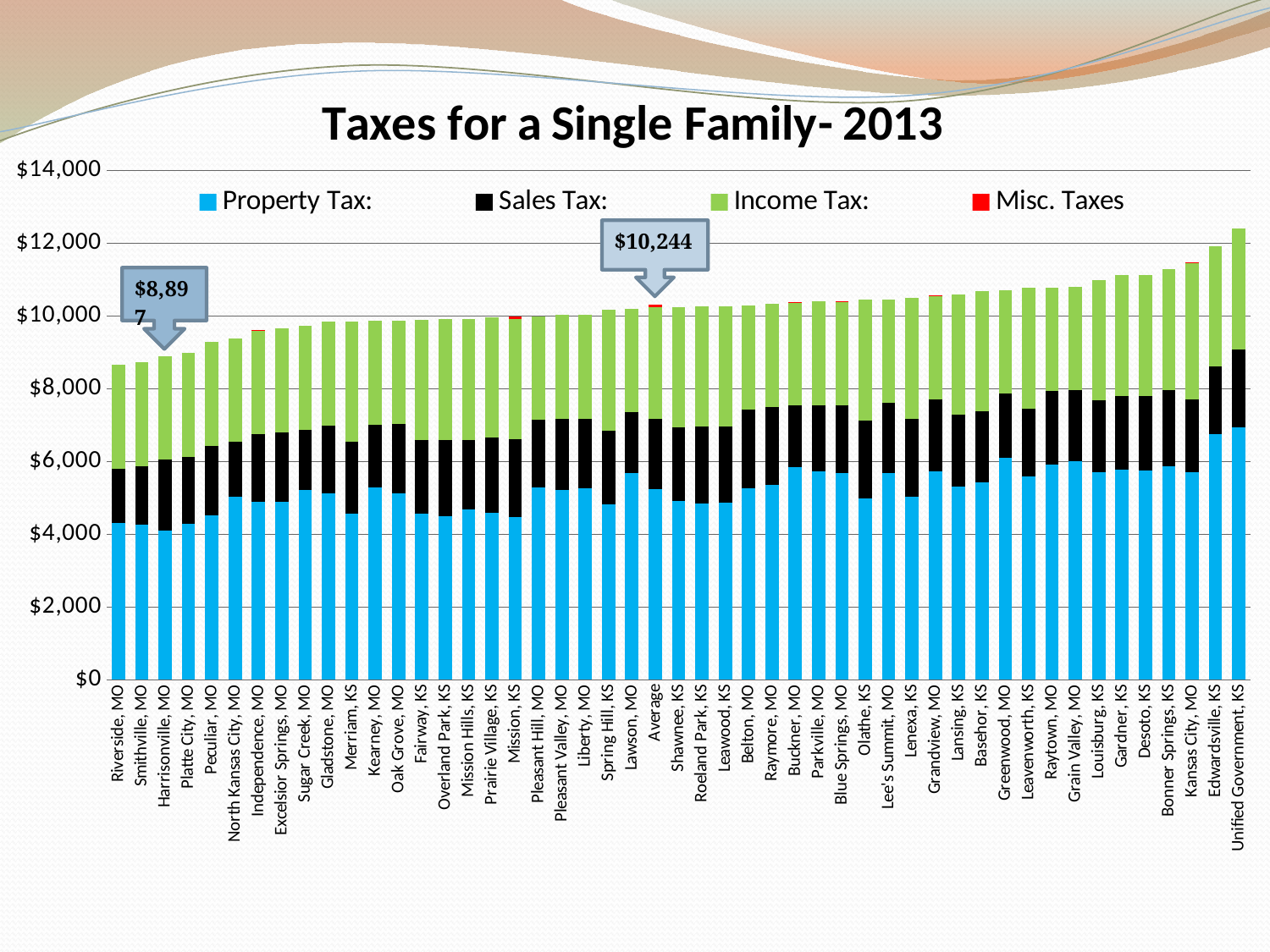
Which category has the lowest total taxes? Riverside, MO Which series is shown in green in the legend? Income Tax What is the difference between the Average total ($10,244) and the Harrisonville, MO total ($8,897)? $1,347 How many series does the legend list? 4 What kind of chart is shown on the slide? Stacked bar chart Which category has the highest total taxes? Unified Government, KS What is the total tax value shown in the callout for Harrisonville, MO? $8,897 Which has a larger total: Edwardsville, KS or Riverside, MO? Edwardsville, KS Do the total taxes rise or fall moving from left to right along the x axis? Rise What is the total tax value shown in the callout for Average? $10,244 Is the total for Riverside, MO greater or less than $10,000? less Is the total for Unified Government, KS greater or less than $12,000? greater